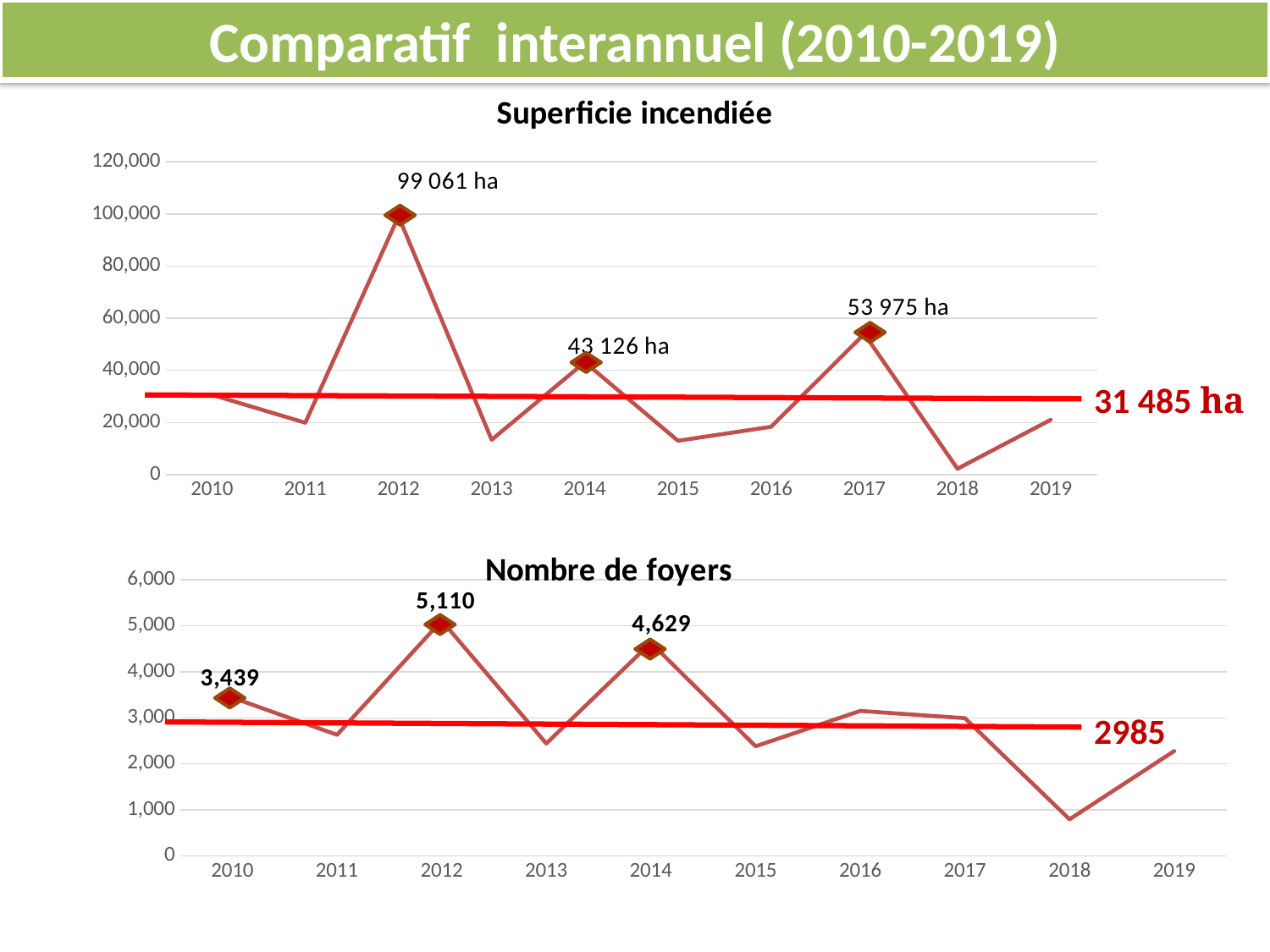
How many years are plotted on the x axis of the 'Nombre de foyers' chart? 10 In the 'Superficie incendiée' chart, what is the value for 2012? 99 061 ha In the 'Superficie incendiée' chart, what is the value for 2017? 53 975 ha In the 'Nombre de foyers' chart, what is the difference between the 2012 and 2010 values? 1,671 In the 'Superficie incendiée' chart, what is the difference between the 2012 and 2017 values? 45 086 ha What type of chart is the 'Superficie incendiée' chart? Line chart In the 'Nombre de foyers' chart, is the value for 2018 greater or less than 1,000? less In the 'Superficie incendiée' chart, is the value for 2013 greater or less than 20,000? less In the 'Nombre de foyers' chart, which year has the highest value? 2012 In the 'Superficie incendiée' chart, which year has the lowest value? 2018 In the 'Superficie incendiée' chart, which is larger, the value for 2014 or the value for 2017? 2017 In the 'Nombre de foyers' chart, what is the value for 2014? 4,629